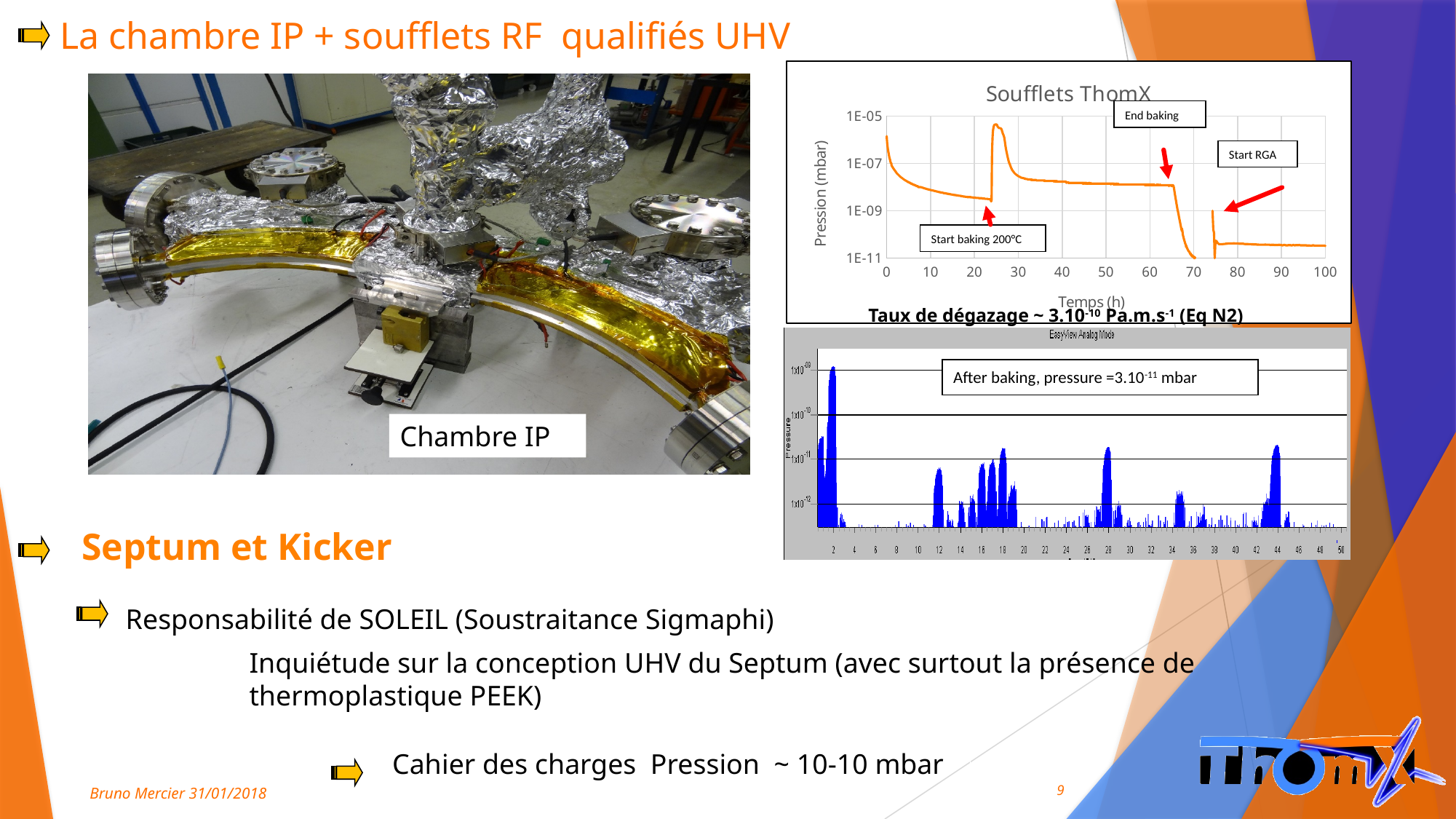
In the 'Soufflets ThomX' chart, what is the highest value shown on the vertical axis? 1E-05 In the 'Soufflets ThomX' chart, is the pressure at 50 h greater or less than 1E-07 mbar? less In the RGA spectrum chart (EasyView Analog Mode), is the peak at mass 28 greater or less than 1x10^-10? less In the 'Soufflets ThomX' chart, what is the largest value shown on the horizontal axis (Temps)? 100 In the 'Soufflets ThomX' chart, what is the label of the vertical axis? Pression (mbar) In the 'Soufflets ThomX' chart, what temperature is given in the 'Start baking' annotation? 200°C What kind of chart is the 'Soufflets ThomX' chart? line chart In the 'Soufflets ThomX' chart, does the pressure rise or fall immediately after the 'End baking' point? fall In the 'Soufflets ThomX' chart, is the pressure at 50 h greater or less than 1E-09 mbar? greater What is the title of the line chart at the top right of the slide? Soufflets ThomX In the RGA spectrum chart (EasyView Analog Mode) at the bottom right, at which mass value is the tallest peak? 2